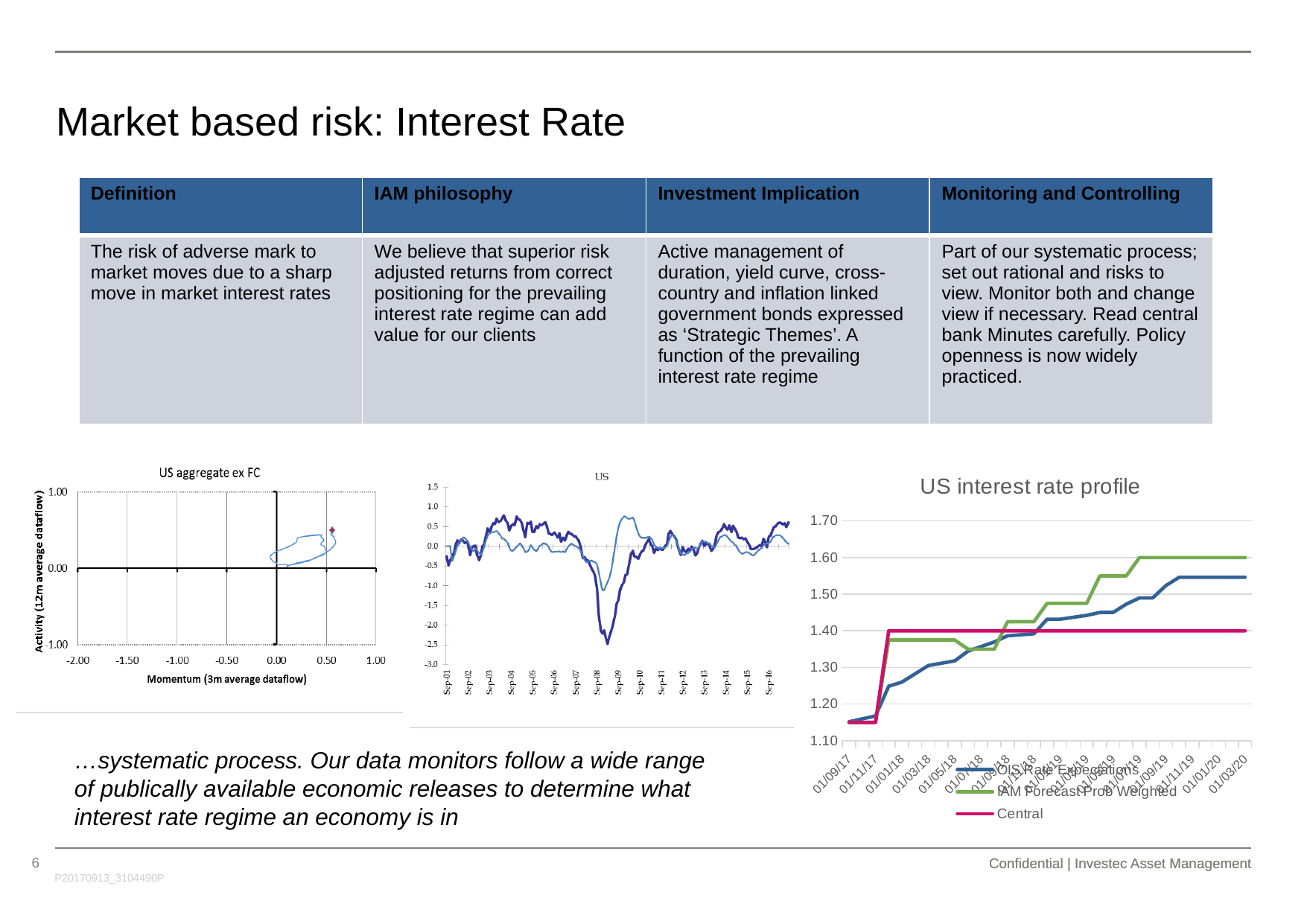
In the 'US interest rate profile' chart, is the value of the IAM Forecast Prob Weighted series at 01/03/20 greater or less than 1.50? greater In the 'US interest rate profile' chart, do the OIS Rate Expectations values generally rise or fall from 01/09/17 to 01/03/20? rise In the 'US interest rate profile' chart, is the value of the OIS Rate Expectations series at 01/09/17 greater or less than 1.20? less In the 'US interest rate profile' chart, which series is highest at the right-hand end of the chart (01/03/20)? IAM Forecast Prob Weighted How many series does the legend of the 'US interest rate profile' chart list? 3 In the 'US interest rate profile' chart, which series is drawn in red? Central What is the x-axis label of the 'US aggregate ex FC' chart? Momentum (3m average dataflow) In the chart titled 'US', is the lowest value of the dark blue line (around Sep-08) greater or less than -2.0? less In the 'US interest rate profile' chart, which series is lowest at the right-hand end of the chart (01/03/20)? Central What kind of chart is the chart titled 'US' in the middle of the slide? line chart What kind of chart is the 'US interest rate profile' chart? line chart